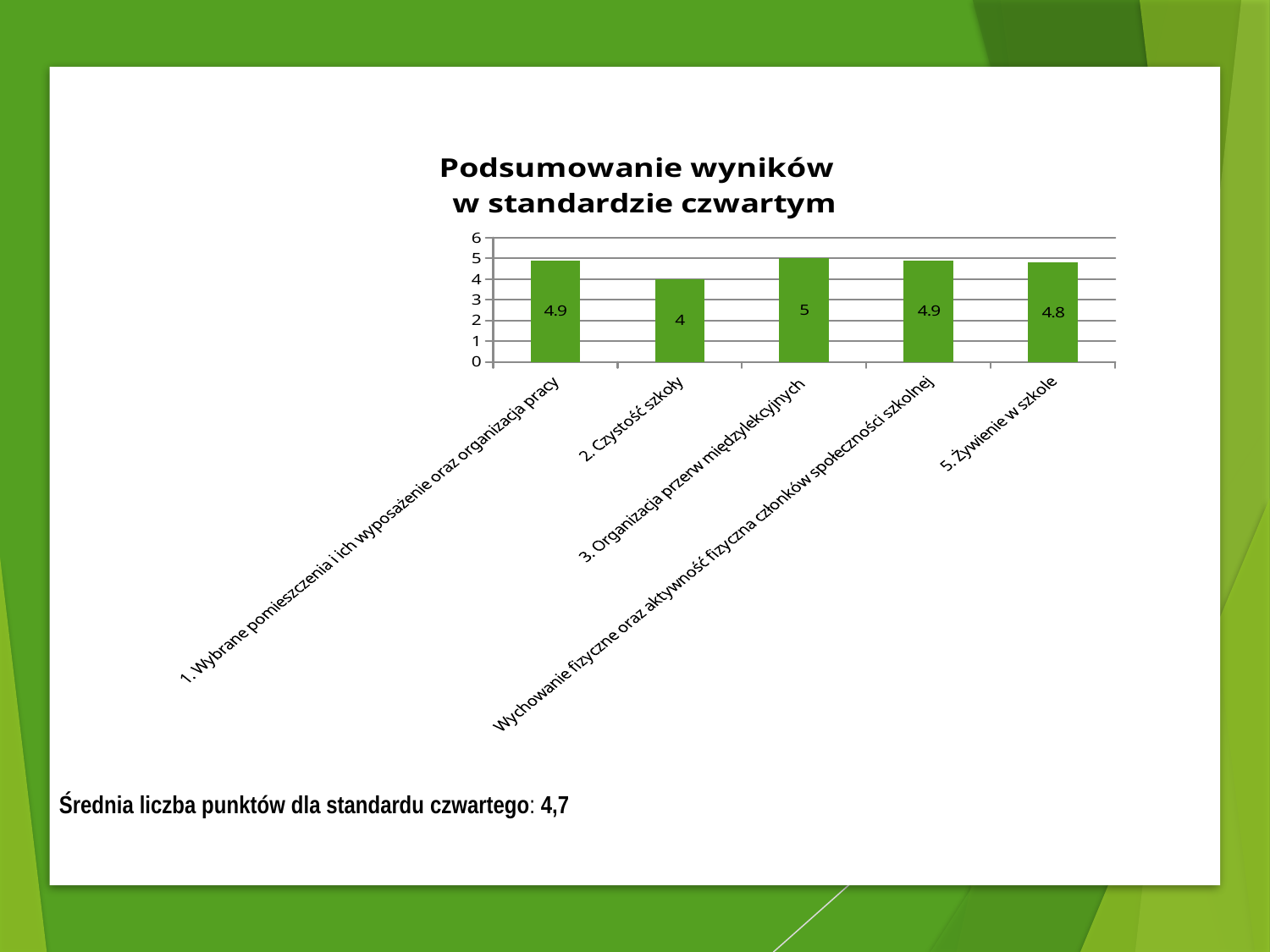
What is the value for "3. Organizacja przerw międzylekcyjnych"? 5 What is the value for "5. Żywienie w szkole"? 4.8 What is the value for "2. Czystość szkoły"? 4 How many categories are shown in the chart? 5 Which is larger: the value for "5. Żywienie w szkole" or the value for "2. Czystość szkoły"? 5. Żywienie w szkole Which category has the lowest value? 2. Czystość szkoły What kind of chart is shown on the slide? bar chart What is the title of the chart? Podsumowanie wyników w standardzie czwartym What is the difference between the values for "3. Organizacja przerw międzylekcyjnych" and "2. Czystość szkoły"? 1 What is the value for "1. Wybrane pomieszczenia i ich wyposażenie oraz organizacja pracy"? 4.9 Which category has the highest value? 3. Organizacja przerw międzylekcyjnych Is the value for "5. Żywienie w szkole" greater or less than 3? greater